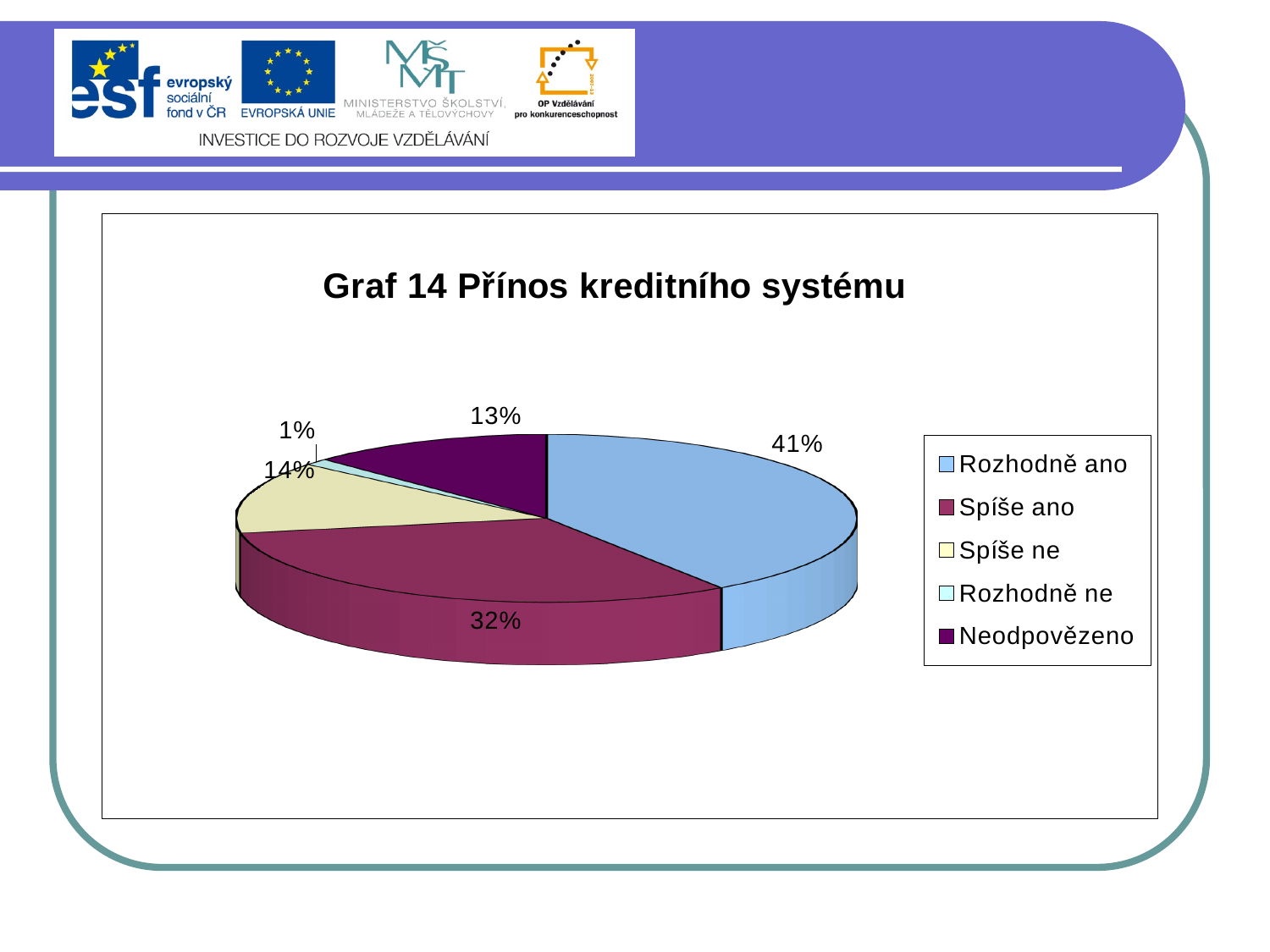
What percentage of the pie is labelled for Rozhodně ano? 41% What type of chart is shown on the slide? pie chart Which category has the largest share of the pie? Rozhodně ano How many categories does the legend list? 5 What is the difference in percentage points between Rozhodně ano and Spíše ano? 9 Which is larger, the share for Spíše ne or the share for Neodpovězeno? Spíše ne What is the title of the chart? Graf 14 Přínos kreditního systému What percentage of the pie is labelled for Spíše ano? 32% What percentage of the pie is labelled for Spíše ne? 14% What percentage of the pie is labelled for Rozhodně ne? 1% Which category has the smallest share of the pie? Rozhodně ne What percentage of the pie is labelled for Neodpovězeno? 13%